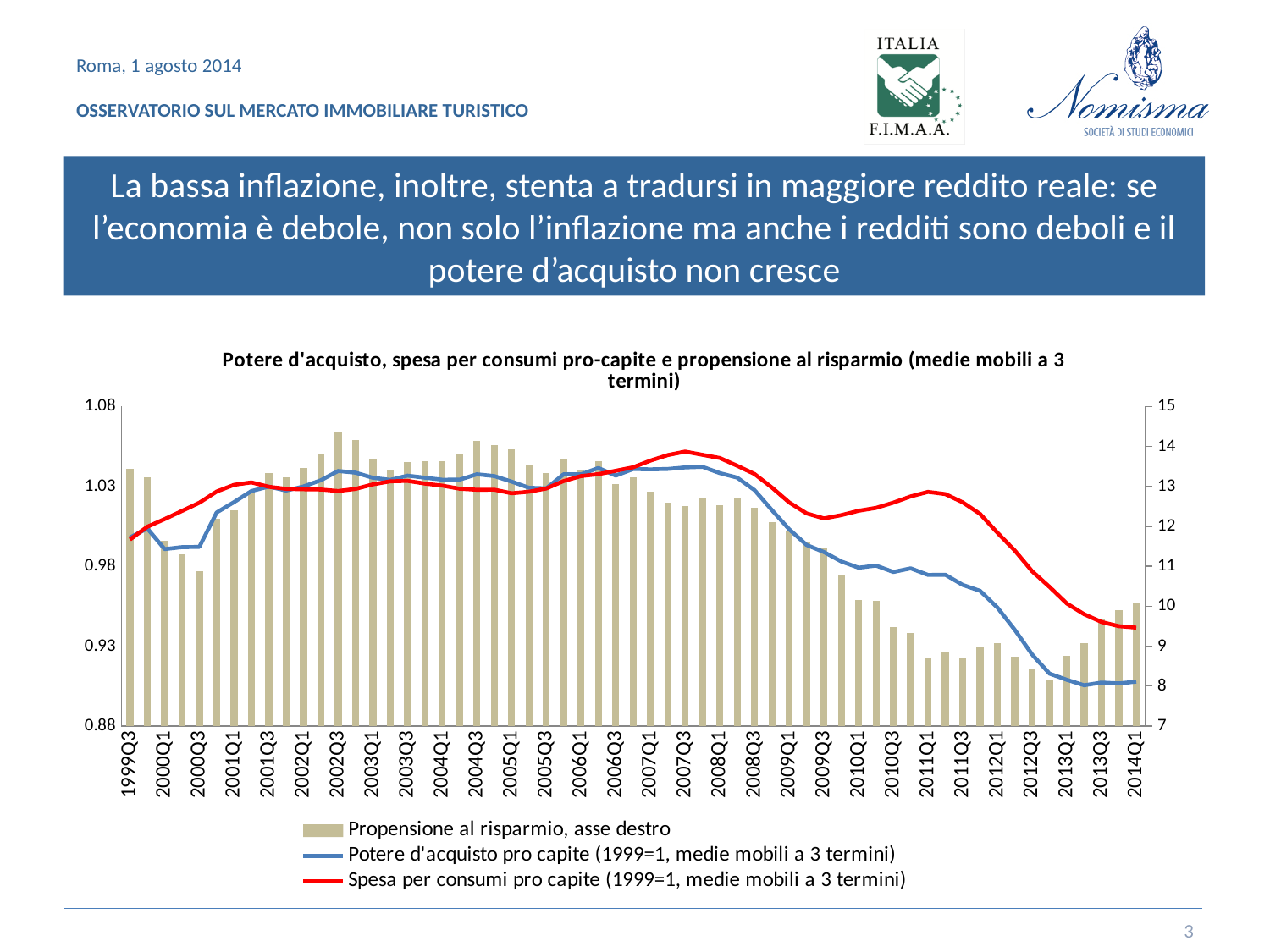
How many series does the legend list? 3 What kind of chart is shown on the slide? A combined bar and line chart Is the value of Propensione al risparmio in 2013Q1 greater or less than 9? less Is the value of Propensione al risparmio in 2002Q3 greater or less than 14? greater Which series is plotted as bars? Propensione al risparmio, asse destro In 2014Q1, which line is higher: Spesa per consumi pro capite or Potere d'acquisto pro capite? Spesa per consumi pro capite What is the highest value shown on the right-hand axis? 15 Is the value of Spesa per consumi pro capite in 2007Q3 greater or less than 1.03? greater What colour is the line for Spesa per consumi pro capite? Red In which quarter does Propensione al risparmio reach its highest value? 2002Q3 Does Potere d'acquisto pro capite rise or fall between 2007Q3 and 2014Q1? Fall